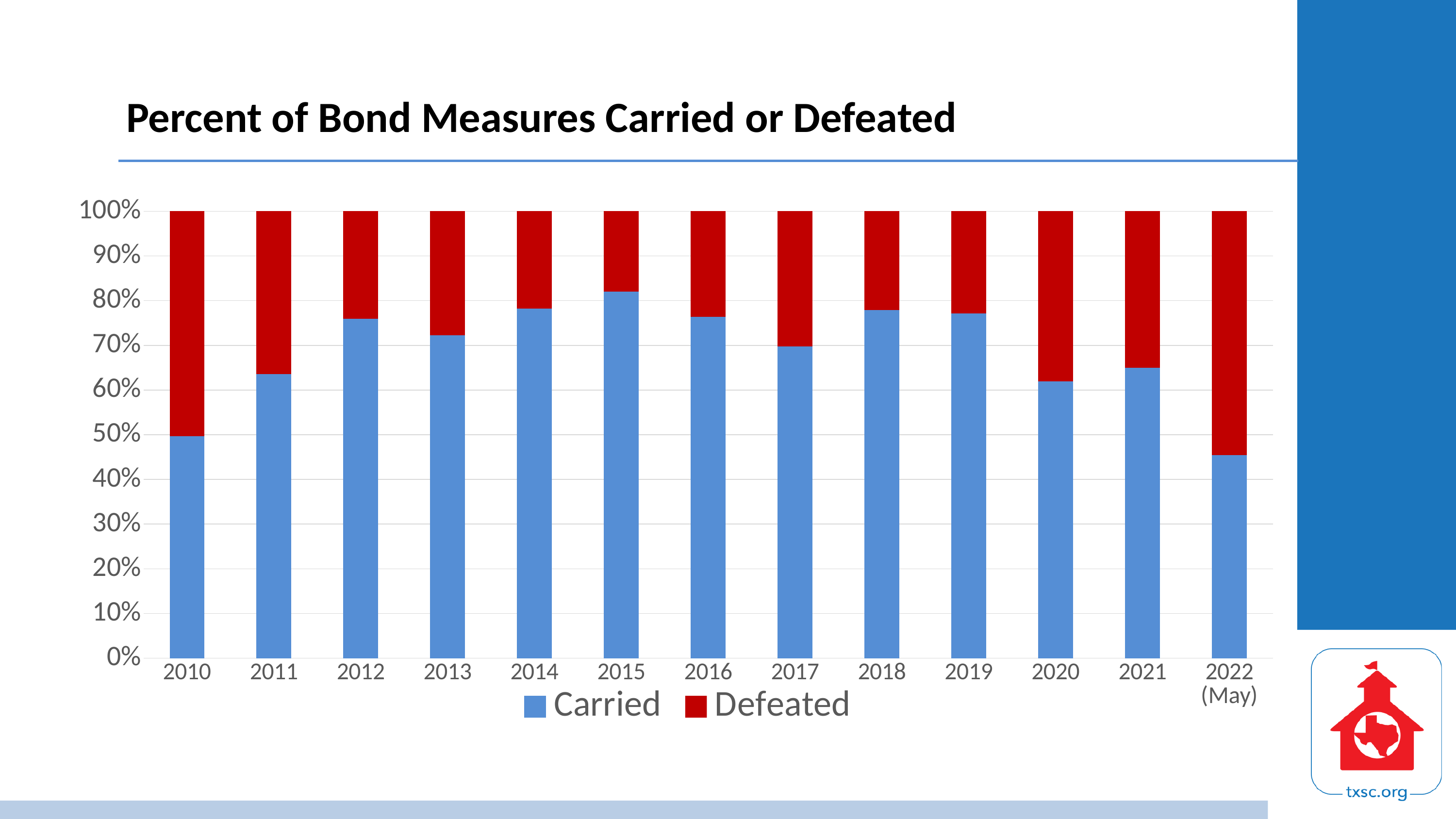
Which year has the largest Defeated share? 2022 (May) Which year has the larger Carried share, 2012 or 2013? 2012 Is the Carried value for 2022 (May) greater or less than 50%? less How many series does the legend list? 2 Is the Carried value for 2012 greater or less than 70%? greater What is the total of the stacked bar for 2015? 100% How many years are shown on the x axis? 13 What colour represents the Defeated series? Red Which year has the highest percentage of bond measures carried? 2015 Which year has the lowest percentage of bond measures carried? 2022 (May) What kind of chart is shown on the slide? Stacked bar chart Is the Carried value for 2011 greater or less than 60%? greater